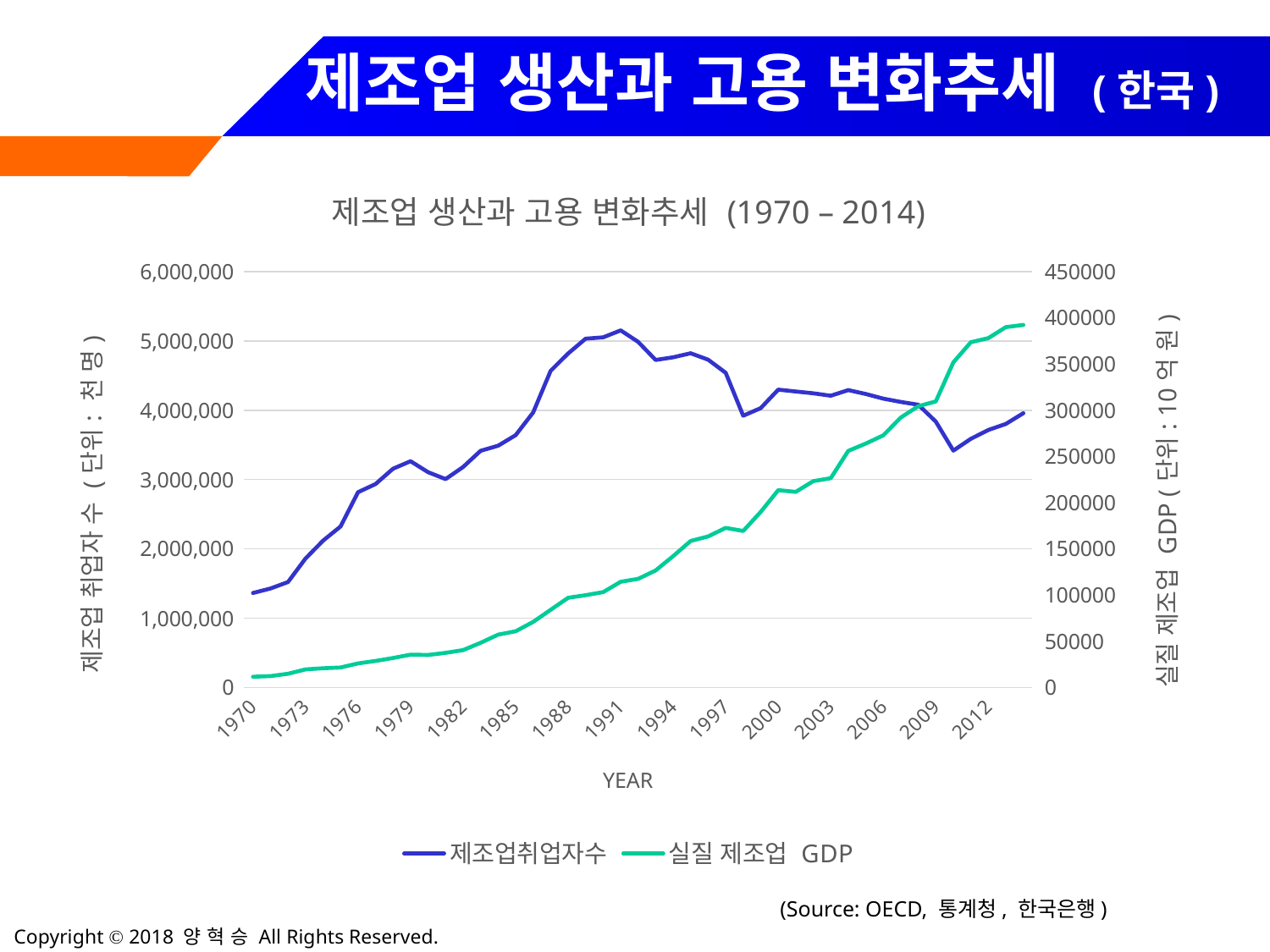
How many series does the legend list? 2 In which year is the 실질 제조업 GDP line at its highest? 2014 Does the 실질 제조업 GDP line generally rise or fall from 1970 to 2014? rise Is the 제조업취업자수 value for 1970 greater or less than 2,000,000? less What kind of chart is shown on the slide? line chart What is the title of the chart? 제조업 생산과 고용 변화추세 (1970 – 2014) Is the 실질 제조업 GDP value for 1970 greater or less than 50000? less Does the 제조업취업자수 line rise or fall between 1970 and 1991? rise Is the 제조업취업자수 value for 1991 greater or less than 5,000,000? greater How many year labels are shown on the x axis? 15 What are the two series named in the legend? 제조업취업자수, 실질 제조업 GDP